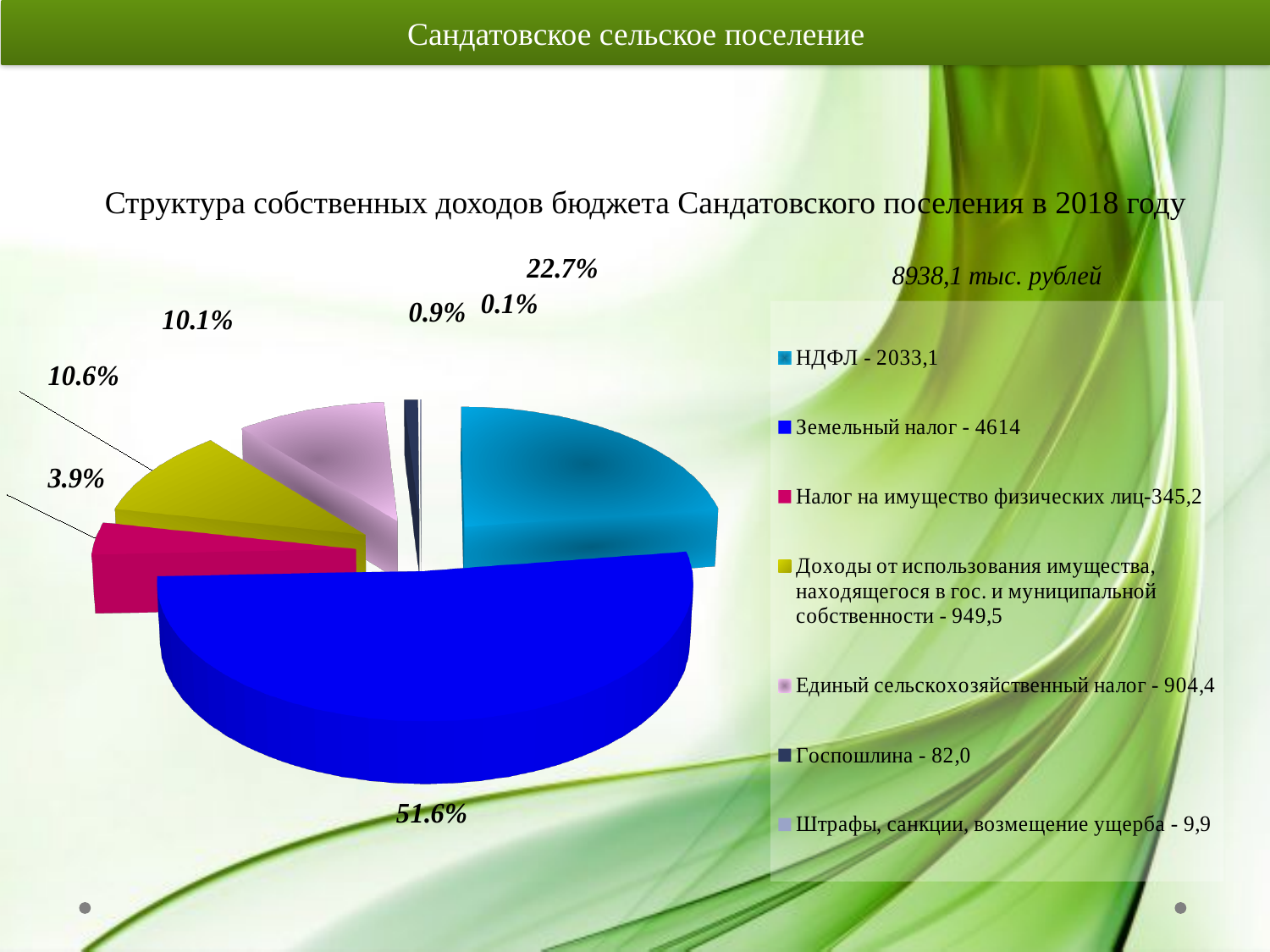
What is the title of the chart? 8938,1 тыс. рублей Which category has the smallest slice of the pie? Штрафы, санкции, возмещение ущерба Which category has the largest slice of the pie? Земельный налог What value is shown in the legend for Госпошлина? 82,0 What share of the pie does Налог на имущество физических лиц take? 3.9% What is the difference in percentage points between the Земельный налог share and the НДФЛ share? 28.9 What value is shown in the legend for Единый сельскохозяйственный налог? 904,4 How many categories does the legend list? 7 Which is larger, the share for НДФЛ or the share for Единый сельскохозяйственный налог? НДФЛ What share of the pie does НДФЛ take? 22.7% What type of chart is shown on the slide? pie chart What share of the pie does Земельный налог take? 51.6%